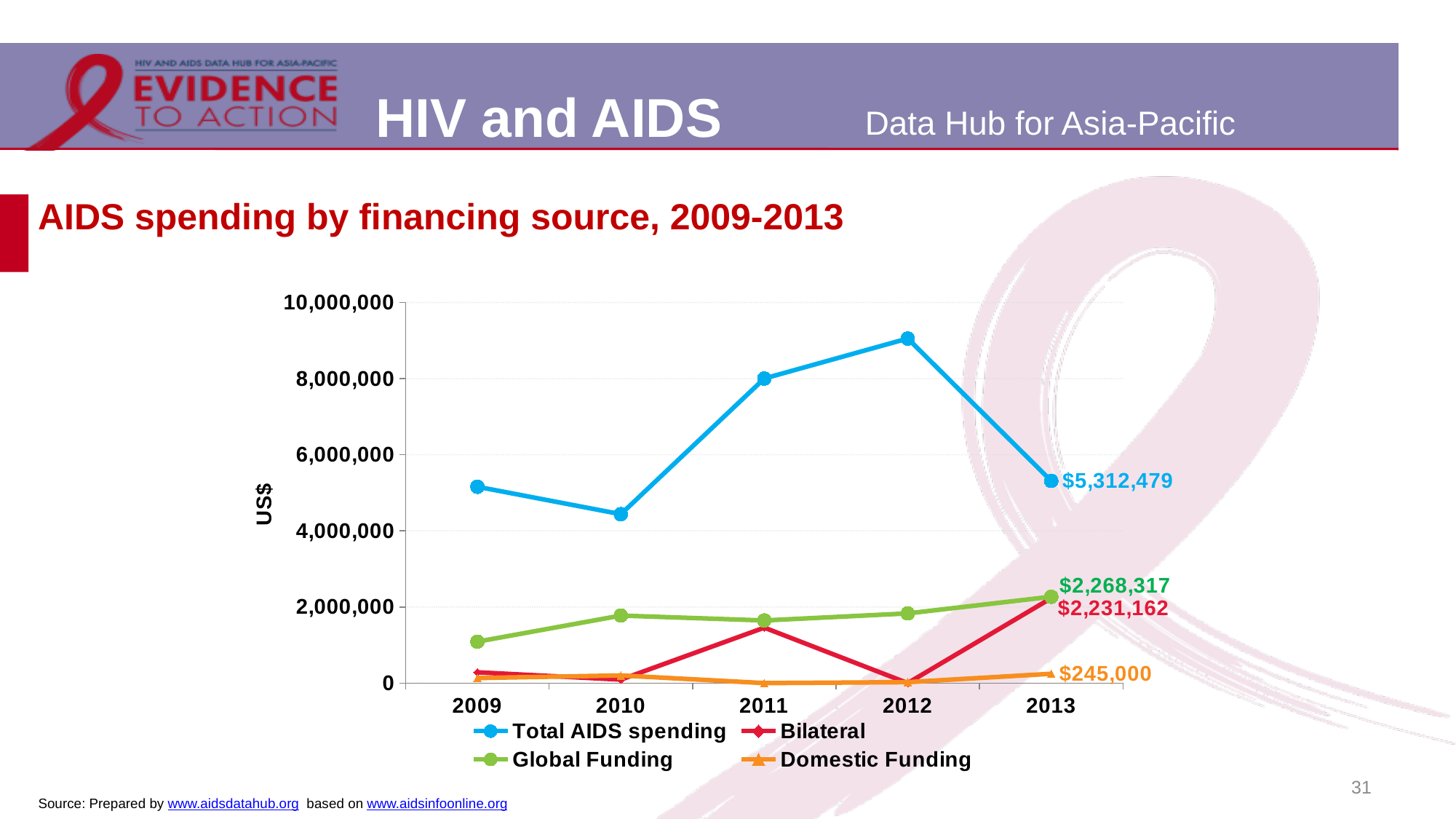
Is the value for Total AIDS spending in 2012 greater or less than 8,000,000? greater In which year was Total AIDS spending lowest? 2010 What is the value for Bilateral funding in 2013? $2,231,162 What is the value for Total AIDS spending in 2013? $5,312,479 In 2013, what is the difference between Total AIDS spending and Global Funding? $3,044,162 What is the value for Global Funding in 2013? $2,268,317 How many series does the legend list? 4 What is the value for Domestic Funding in 2013? $245,000 What kind of chart is shown on the slide? Line chart In which year was Total AIDS spending highest? 2012 In 2013, how much larger is Global Funding than Bilateral funding? $37,155 Which is larger in 2013: Global Funding or Bilateral funding? Global Funding